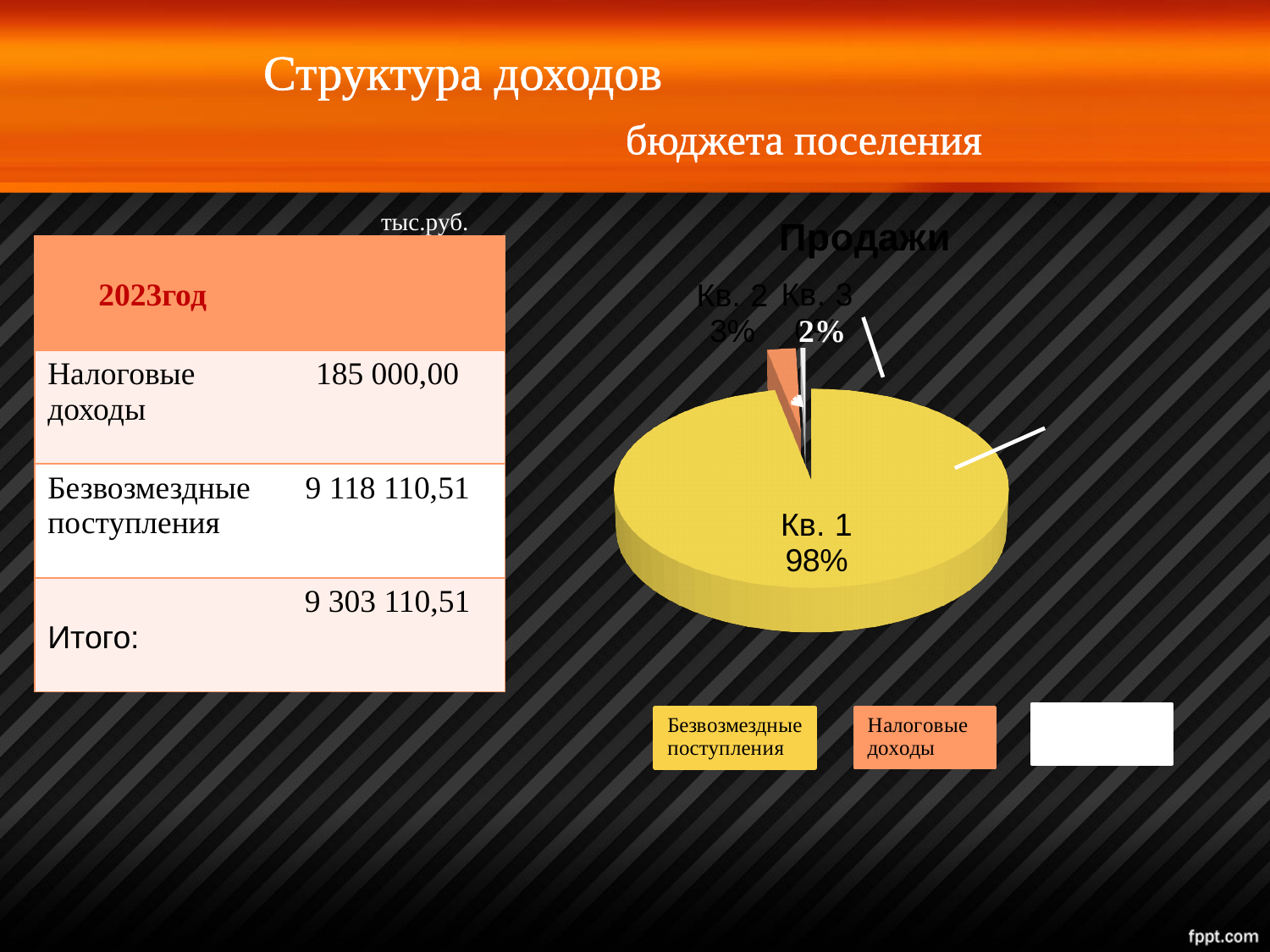
What percentage is shown for the Кв. 1 slice of the pie chart? 98% How many slices does the pie chart have? 3 What kind of chart is shown on the slide? pie chart Which slice of the pie chart is the smallest? Кв. 3 Which is larger in the pie chart, the Кв. 1 slice or the Кв. 3 slice? Кв. 1 What is the difference in percentage points between the Кв. 1 slice and the Кв. 2 slice of the pie chart? 95 What percentage is shown for the Кв. 3 slice of the pie chart? 2% Which slice of the pie chart is the largest? Кв. 1 What percentage is shown for the Кв. 2 slice of the pie chart? 3% What is the title of the pie chart? Продажи What colour is the Кв. 1 slice of the pie chart? yellow